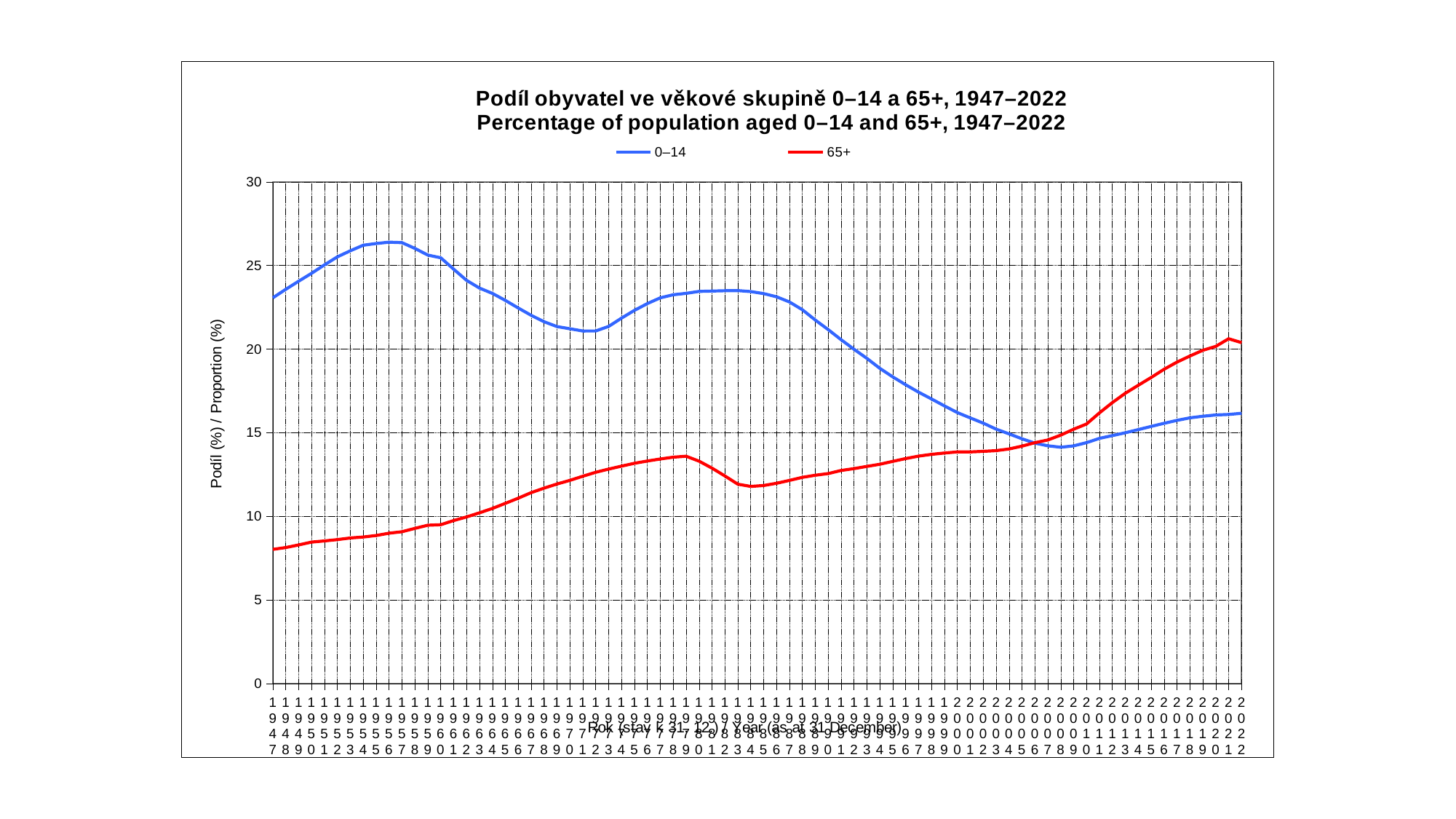
What kind of chart is shown on the slide? line chart Is the value for the 0–14 series in 1956 greater or less than 25? greater In 1947, which series has the larger value, 0–14 or 65+? 0–14 How many years are plotted along the x axis? 76 Is the value for the 65+ series in 2022 greater or less than 20? greater Does the 65+ series generally rise or fall from 1947 to 2022? rise Is the value for the 0–14 series in 1947 greater or less than 20? greater How many series does the legend list? 2 In 2022, which series has the larger value, 0–14 or 65+? 65+ What are the two series named in the legend? 0–14 and 65+ Which colour is used for the 65+ series? red